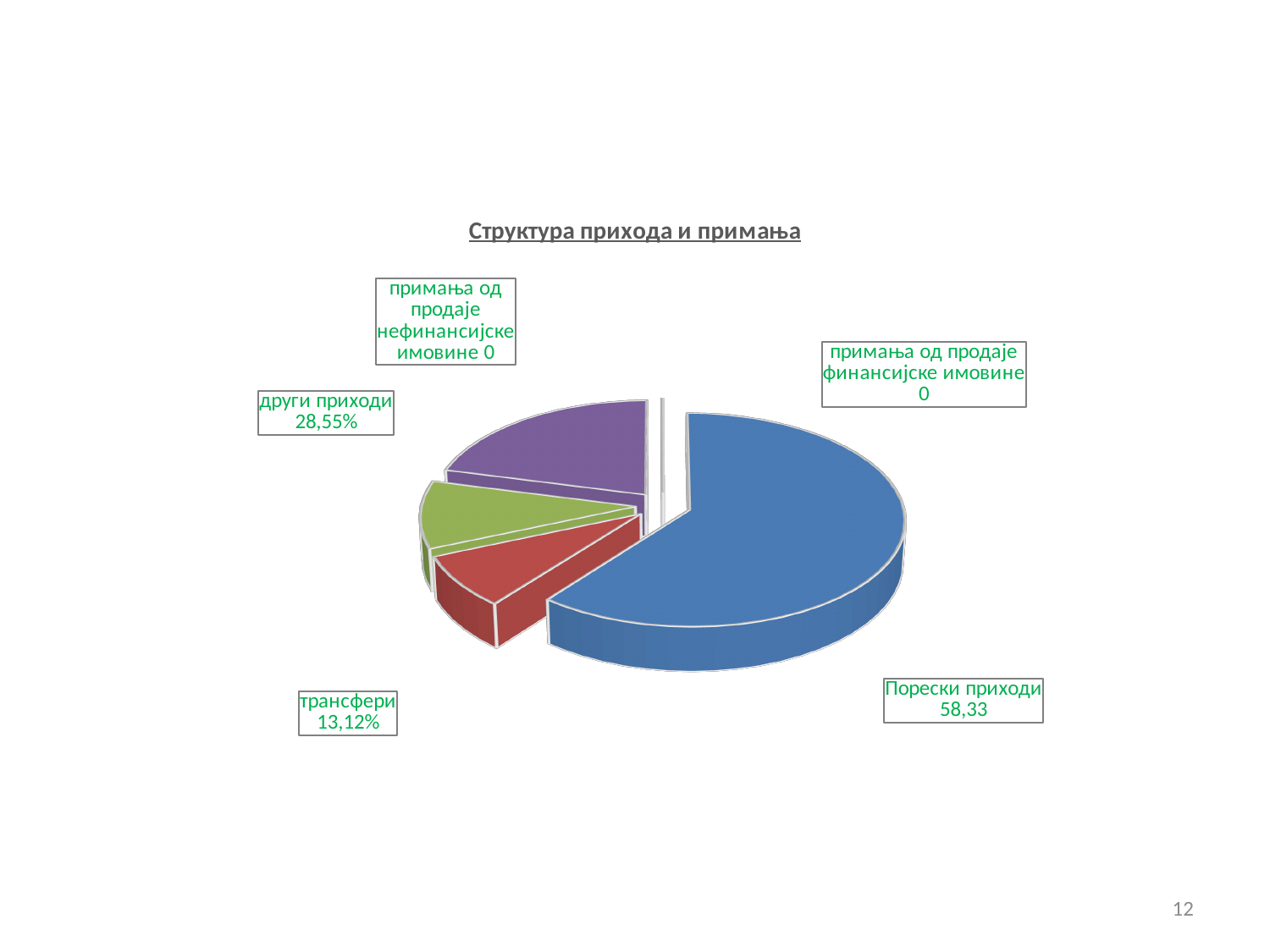
What value is shown for Порески приходи? 58,33 How many categories are labelled on the chart? 5 What share is shown for трансфери? 13,12% What value is shown for примања од продаје финансијске имовине? 0 What is the difference between the shares of други приходи and трансфери? 15,43% What colour is the largest slice of the pie? blue What is the title of the chart? Структура прихода и примања Which category has the largest share of the pie? Порески приходи What kind of chart is shown on the slide? pie chart What share is shown for други приходи? 28,55% What value is shown for примања од продаје нефинансијске имовине? 0 Which is larger, други приходи or трансфери? други приходи